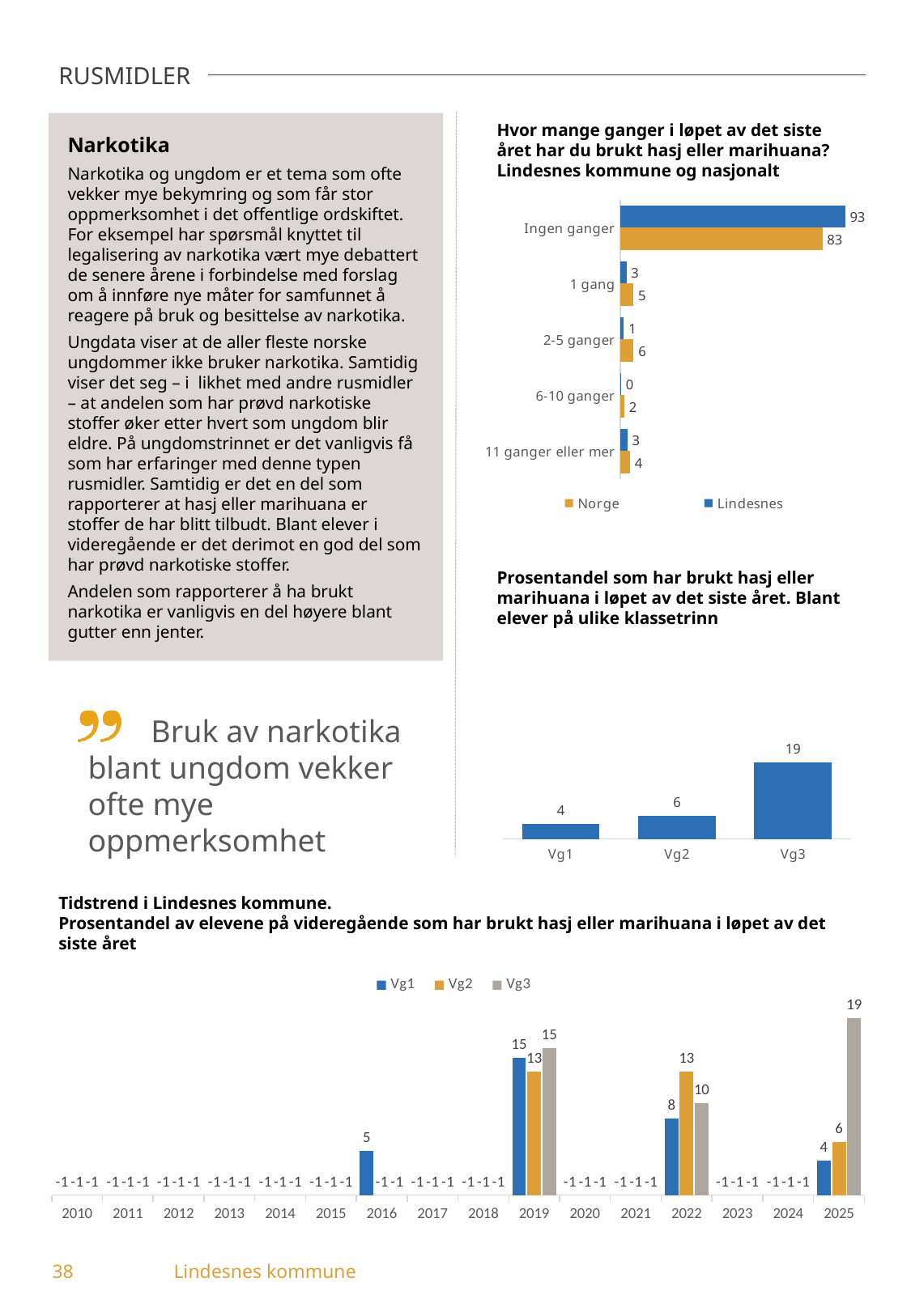
In the chart 'Hvor mange ganger i løpet av det siste året har du brukt hasj eller marihuana?', what is the difference between Lindesnes and Norge for 'Ingen ganger'? 10 In the chart 'Hvor mange ganger i løpet av det siste året har du brukt hasj eller marihuana?', which is larger for '1 gang': Norge or Lindesnes? Norge How many categories are shown in the chart 'Hvor mange ganger i løpet av det siste året har du brukt hasj eller marihuana?'? 5 In the chart 'Hvor mange ganger i løpet av det siste året har du brukt hasj eller marihuana?', what is the value for Norge in the category '2-5 ganger'? 6 In the chart 'Prosentandel som har brukt hasj eller marihuana i løpet av det siste året. Blant elever på ulike klassetrinn', which class level has the highest value? Vg3 In the chart 'Tidstrend i Lindesnes kommune', what is the value for Vg3 in 2025? 19 In the chart 'Tidstrend i Lindesnes kommune', what is the value for Vg1 in 2016? 5 In the chart 'Prosentandel som har brukt hasj eller marihuana i løpet av det siste året. Blant elever på ulike klassetrinn', what is the value for Vg2? 6 How many series does the legend list in the chart 'Hvor mange ganger i løpet av det siste året har du brukt hasj eller marihuana?'? 2 In the chart 'Tidstrend i Lindesnes kommune', what is the difference between Vg2 and Vg1 in 2022? 5 In the chart 'Hvor mange ganger i løpet av det siste året har du brukt hasj eller marihuana?', what is the value for Lindesnes in the category 'Ingen ganger'? 93 What kind of chart is 'Prosentandel som har brukt hasj eller marihuana i løpet av det siste året. Blant elever på ulike klassetrinn'? Bar chart